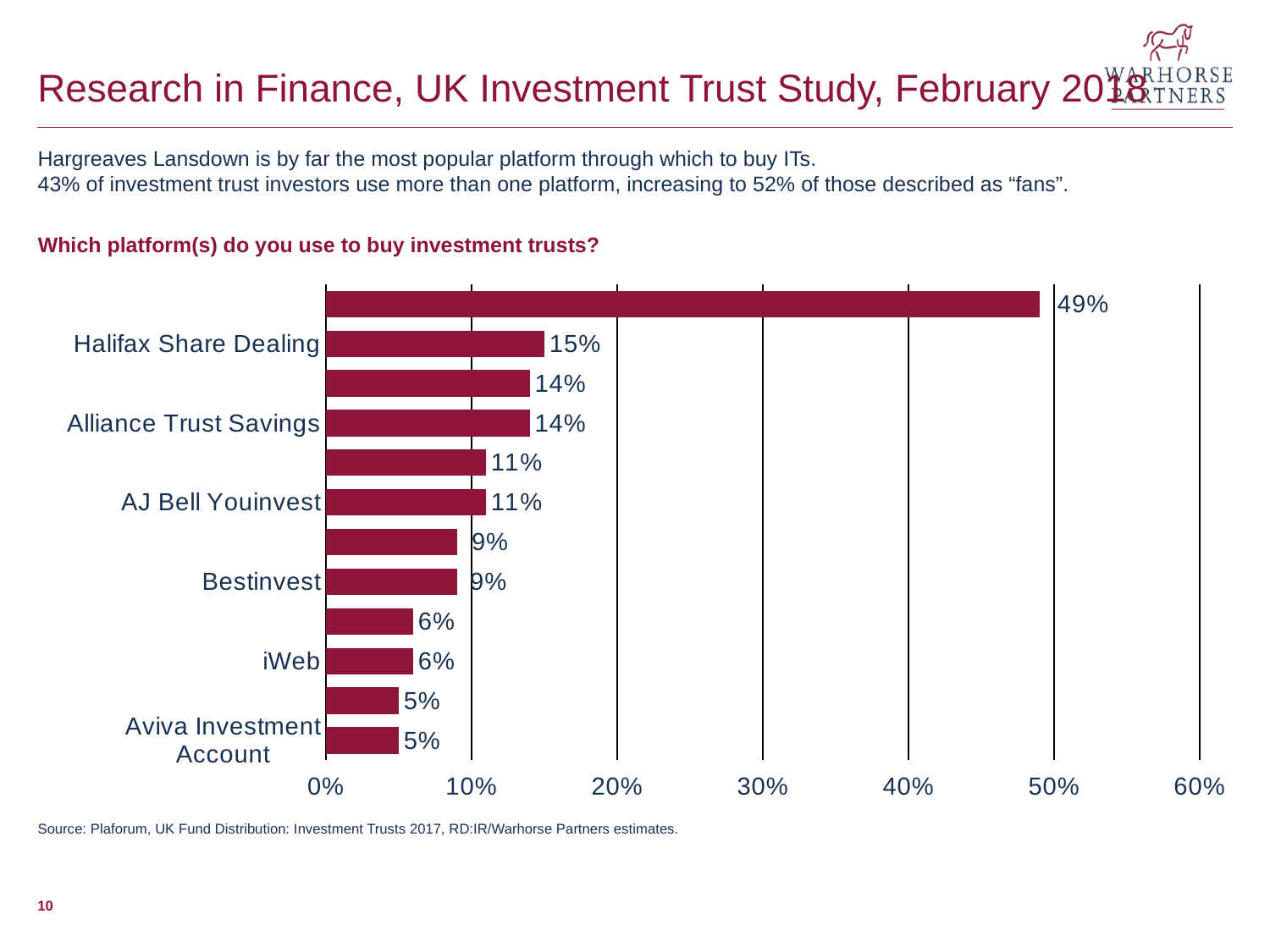
What kind of chart is shown on the slide? Bar chart What value is shown for Aviva Investment Account? 5% What is the difference between the values for Halifax Share Dealing and Aviva Investment Account? 10 percentage points What value is shown for iWeb? 6% What is the title of the chart? Which platform(s) do you use to buy investment trusts? What value is shown for AJ Bell Youinvest? 11% How many bars are plotted on the chart? 12 What percentage of respondents use Halifax Share Dealing to buy investment trusts? 15% What value is shown for Bestinvest? 9% What value is shown for Alliance Trust Savings? 14% What is the highest value shown on the chart? 49% Which has a larger value, Halifax Share Dealing or Bestinvest? Halifax Share Dealing